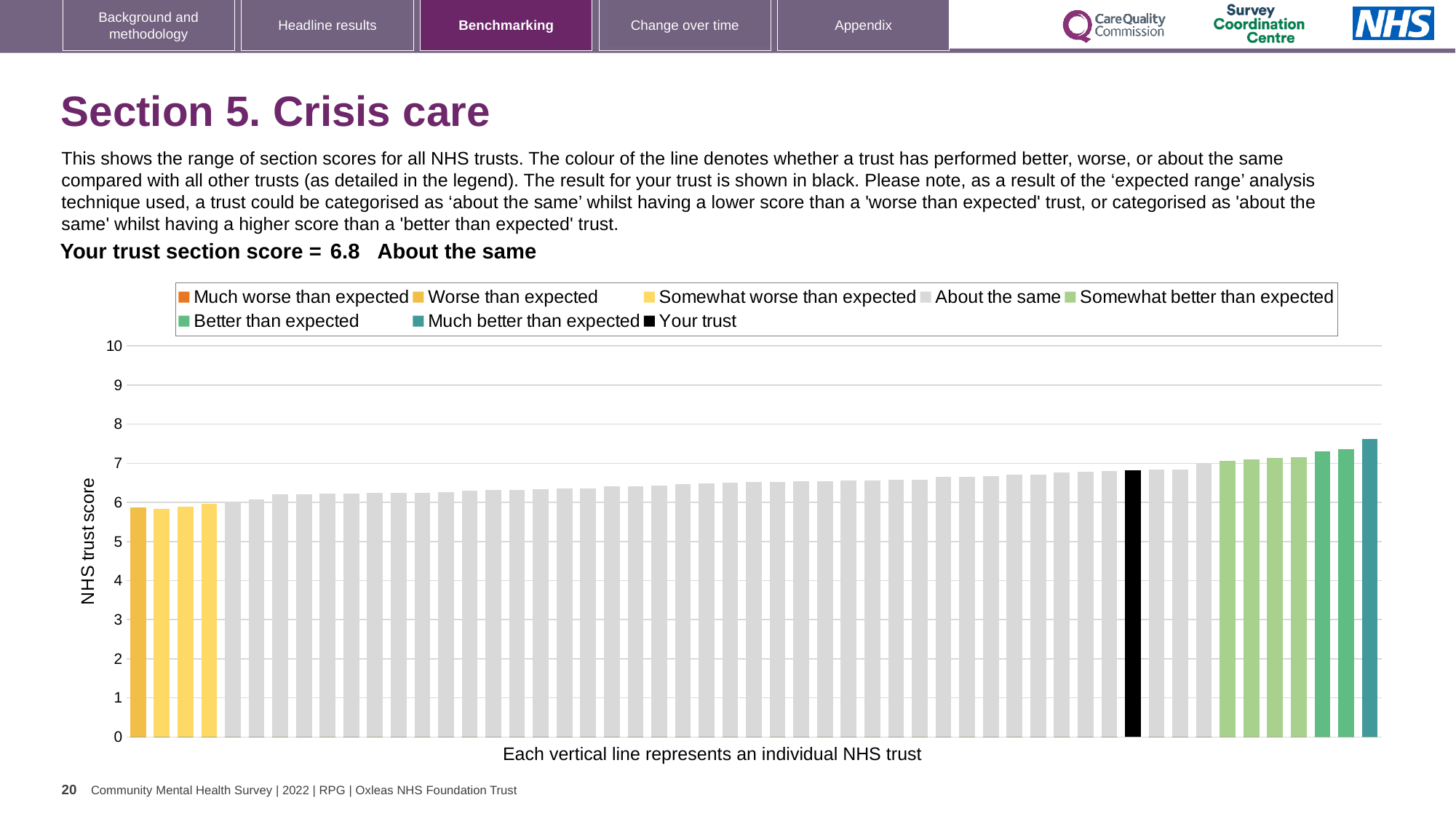
What kind of chart is shown on the slide? bar chart Which category is your trust's section score placed in? About the same Do the bar values rise or fall from left to right along the x axis? rise What is the section score for your trust shown on the slide? 6.8 What is the highest value shown on the vertical axis? 10 Which bar is larger: the rightmost bar or the leftmost bar? the rightmost bar What does the black bar in the chart represent, according to the legend? Your trust Is the value of the rightmost (tallest) bar greater or less than 7? greater How many entries does the chart legend list? 8 Is the value of the leftmost bar greater or less than 7? less Is the value of the black bar (your trust) greater or less than 6? greater What is the label on the vertical axis of the chart? NHS trust score